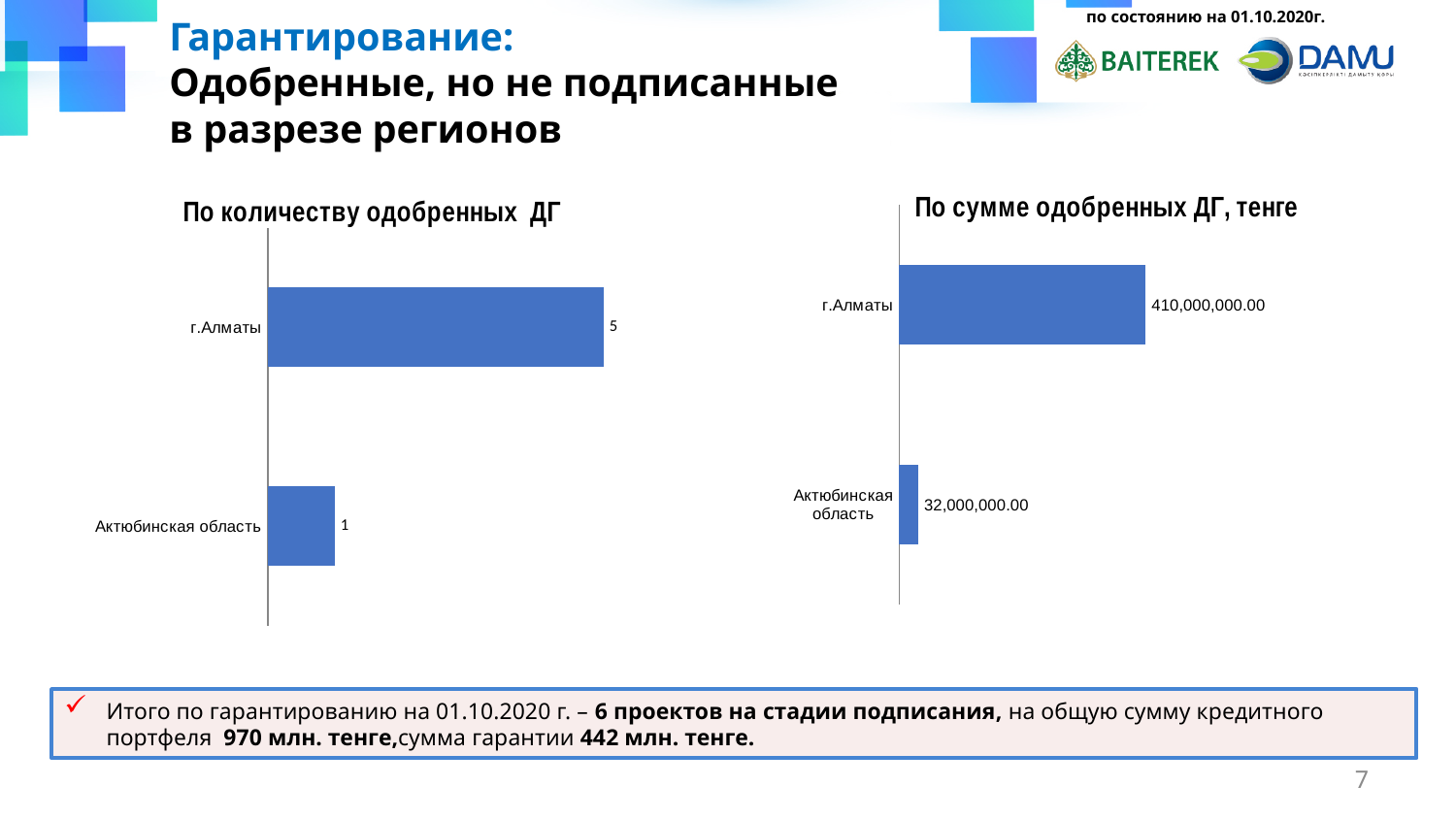
In the chart 'По количеству одобренных ДГ', which region has the highest value? г.Алматы In the chart 'По сумме одобренных ДГ, тенге', what is the value for Актюбинская область? 32,000,000.00 In the chart 'По количеству одобренных ДГ', what is the value for Актюбинская область? 1 What is the title of the chart on the right side of the slide? По сумме одобренных ДГ, тенге In the chart 'По сумме одобренных ДГ, тенге', which is larger: the value for г.Алматы or for Актюбинская область? г.Алматы In the chart 'По сумме одобренных ДГ, тенге', what is the difference between the values for г.Алматы and Актюбинская область? 378,000,000.00 In the chart 'По количеству одобренных ДГ', what is the value for г.Алматы? 5 How many categories are shown in the chart 'По количеству одобренных ДГ'? 2 In the chart 'По сумме одобренных ДГ, тенге', what is the value for г.Алматы? 410,000,000.00 In the chart 'По сумме одобренных ДГ, тенге', which region has the lowest value? Актюбинская область In the chart 'По количеству одобренных ДГ', what is the difference between the values for г.Алматы and Актюбинская область? 4 What kind of chart is 'По сумме одобренных ДГ, тенге'? Bar chart